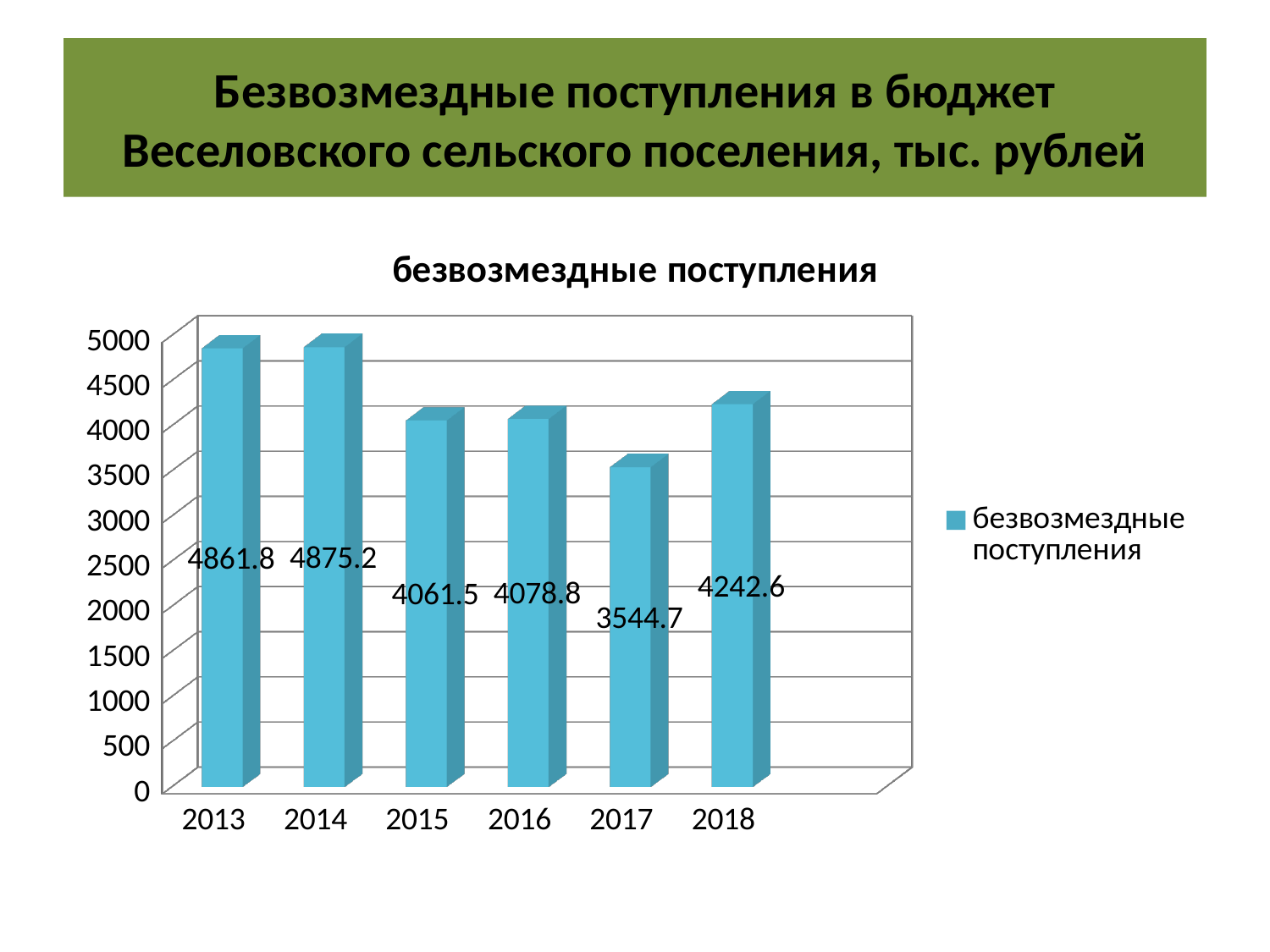
How many series does the legend list? 1 Which year has the lowest value? 2017 What is the value for 2018? 4242.6 Which is larger, the value for 2015 or the value for 2016? 2016 What is the value for 2017? 3544.7 Is the value for 2017 greater or less than 4000? less How many years are shown on the x axis? 6 Which year has the highest value? 2014 What is the value for 2013? 4861.8 What is the difference between the values for 2014 and 2013? 13.4 What kind of chart is shown on the slide? bar chart What is the difference between the values for 2018 and 2017? 697.9